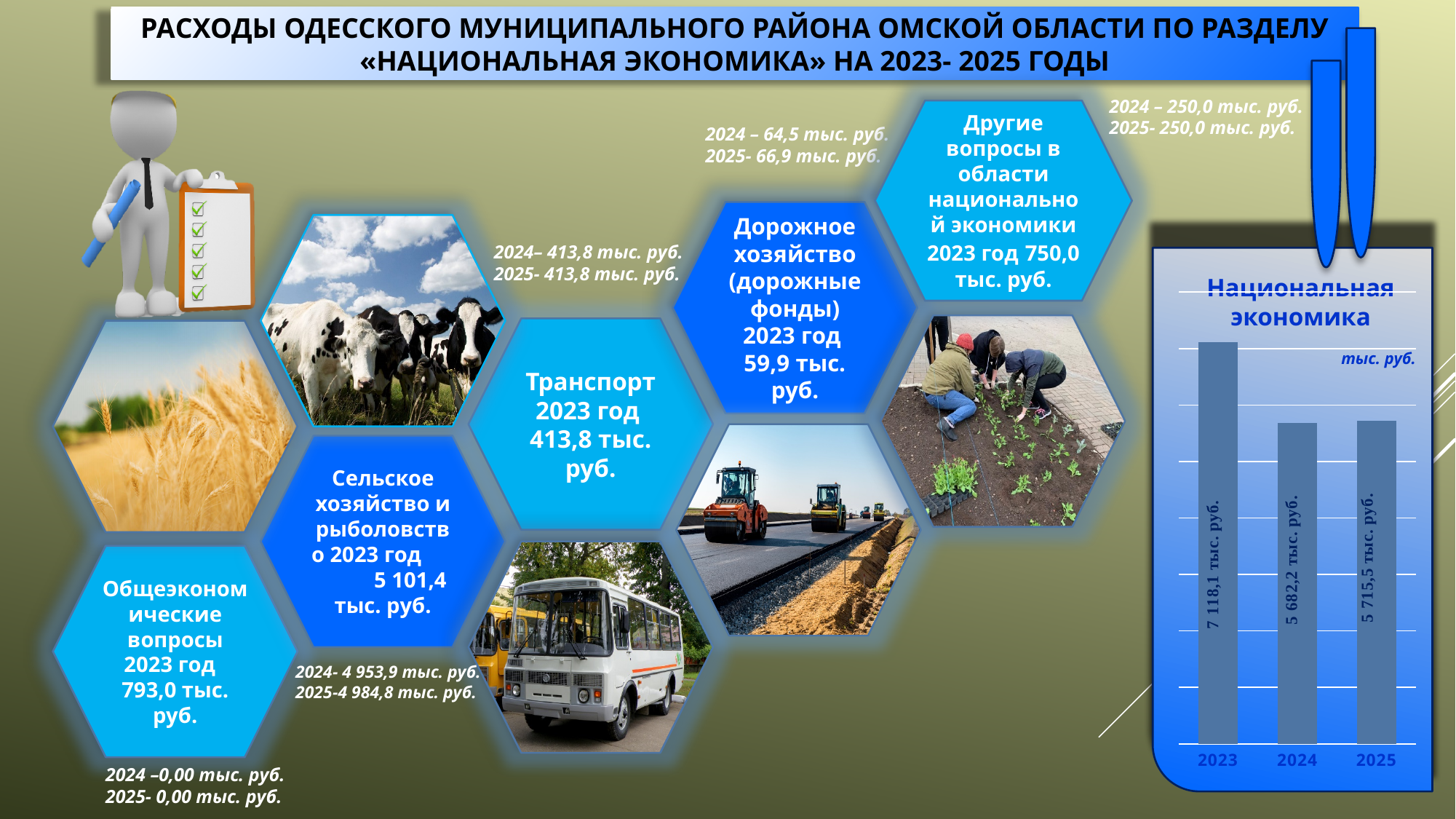
Which year has the lowest value in the chart? 2024 What kind of chart is shown on the slide? bar chart Which year has the highest value in the chart? 2023 Which is larger, the value for 2024 or the value for 2025? 2025 What is the value for 2025 in the chart? 5 715,5 тыс. руб. What is the title of the chart? Национальная экономика What is the difference between the values for 2023 and 2024? 1 435,9 тыс. руб. What is the difference between the values for 2025 and 2024? 33,3 тыс. руб. How many years are plotted in the chart? 3 What is the value for 2023 in the chart? 7 118,1 тыс. руб. Does the value fall or rise from 2023 to 2024? fall What is the value for 2024 in the chart? 5 682,2 тыс. руб.